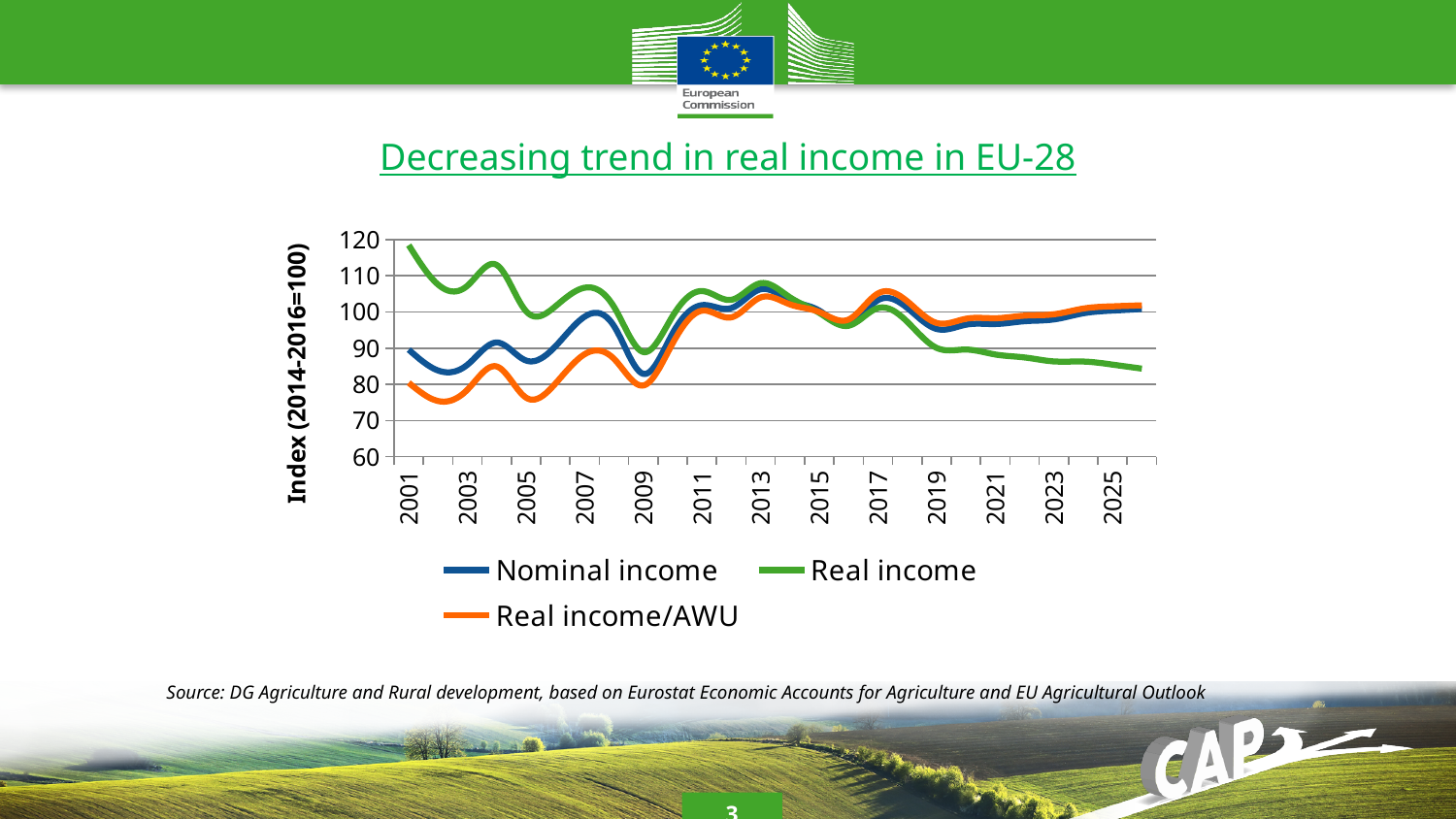
In 2025, which series has the higher value: Nominal income or Real income? Nominal income In 2001, which series has the higher value: Real income or Nominal income? Real income Does the Real income series rise or fall between 2017 and 2025? Fall Is the value for Real income in 2025 greater or less than 90? less Is the value for Real income in 2001 greater or less than 110? greater How many series does the legend list? 3 Which series has the highest value in 2001? Real income Is the value for Real income/AWU in 2001 greater or less than 90? less What is the title of the chart? Decreasing trend in real income in EU-28 What kind of chart is shown on the slide? Line chart What is the label of the vertical axis? Index (2014-2016=100)